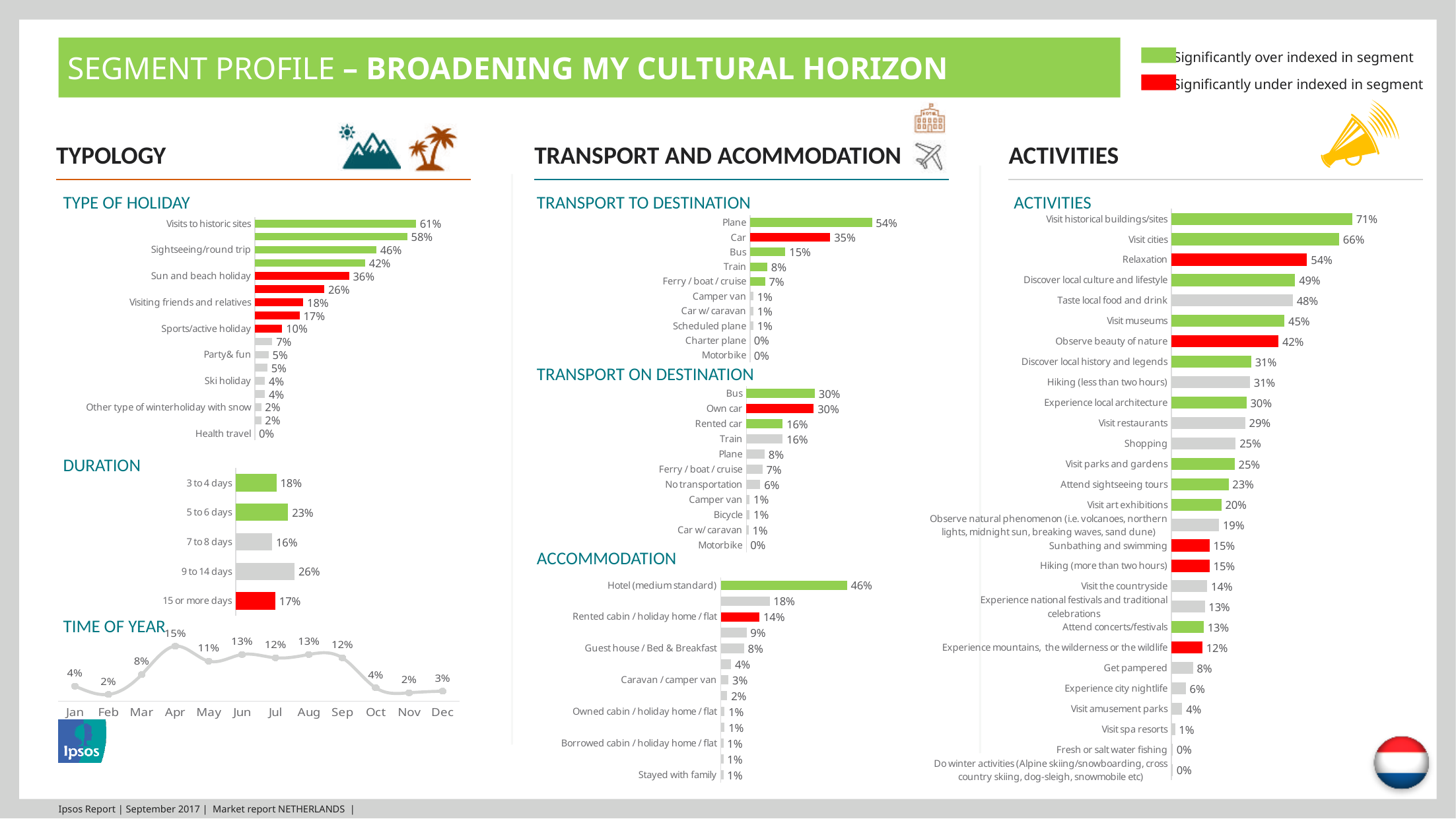
In the Transport to Destination chart, what is the difference between the values for Plane and Car? 19% In the Activities chart, which is larger: Relaxation or Visit cities? Visit cities In the Activities chart, which activity has the highest value? Visit historical buildings/sites In the Transport to Destination chart, what is the value for Plane? 54% In the Duration chart, which duration has the lowest value? 7 to 8 days How many months are plotted in the Time of Year chart? 12 In the Accommodation chart, what is the value for Hotel (medium standard)? 46% What kind of chart is the Time of Year chart? Line chart In the Transport on Destination chart, what is the value for Rented car? 16% In the Time of Year chart, which month has the highest value? Apr In the Activities chart, what is the value for Visit museums? 45% In the Duration chart, what is the difference between the values for 9 to 14 days and 3 to 4 days? 8%